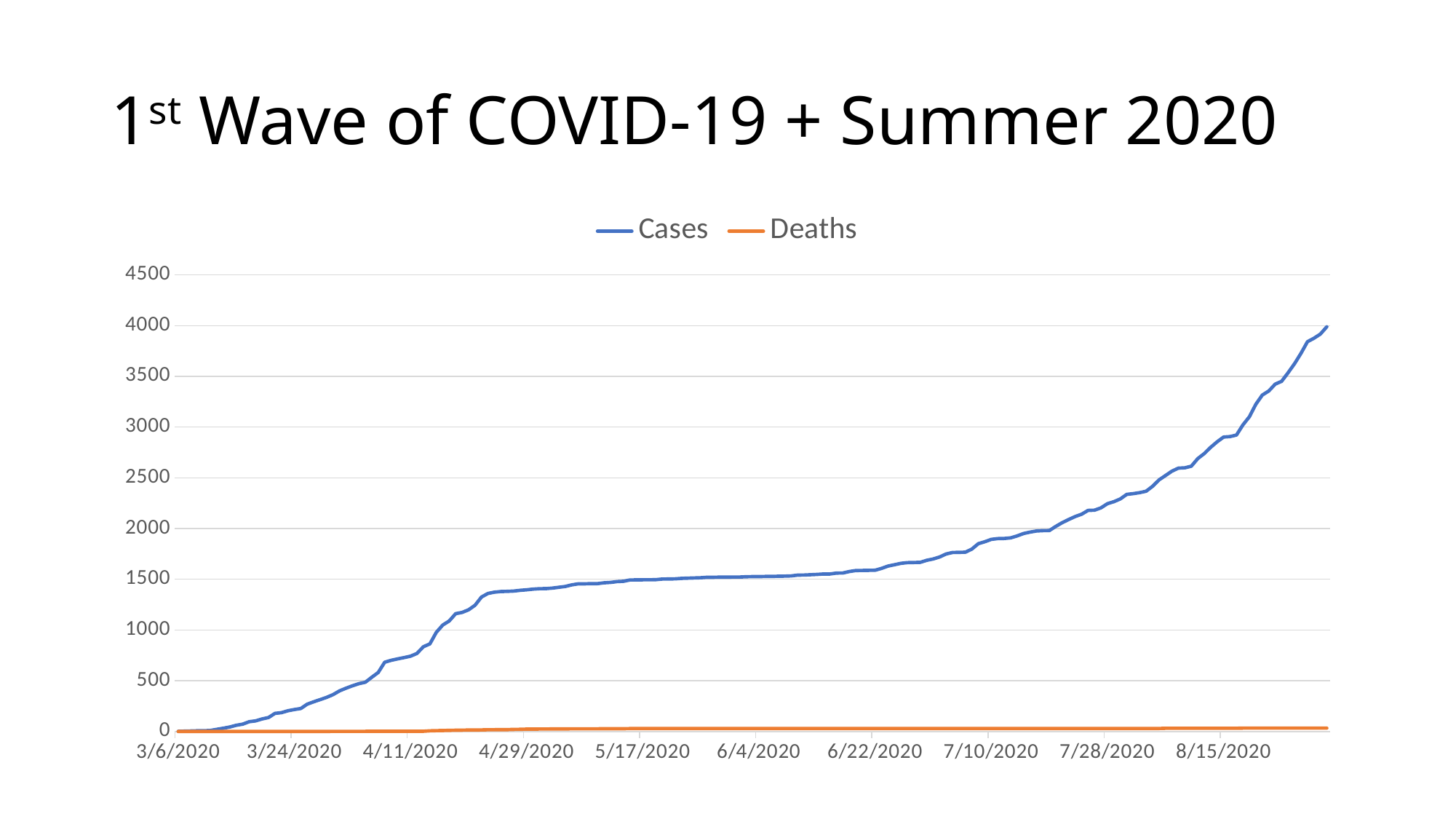
Is the value for Cases at 4/11/2020 greater or less than 1000? less What kind of chart is shown on the slide? line chart Is the value for Cases at 8/15/2020 greater or less than 2000? greater Do the Cases values rise or fall from 3/6/2020 to the end of the chart? rise Which series has the higher value at the end of the chart, Cases or Deaths? Cases How many series does the legend list? 2 Is the value for Cases at 6/4/2020 greater or less than 1000? greater How many date labels are shown on the x axis? 10 What are the two series named in the legend? Cases and Deaths What colour is the Cases line? blue